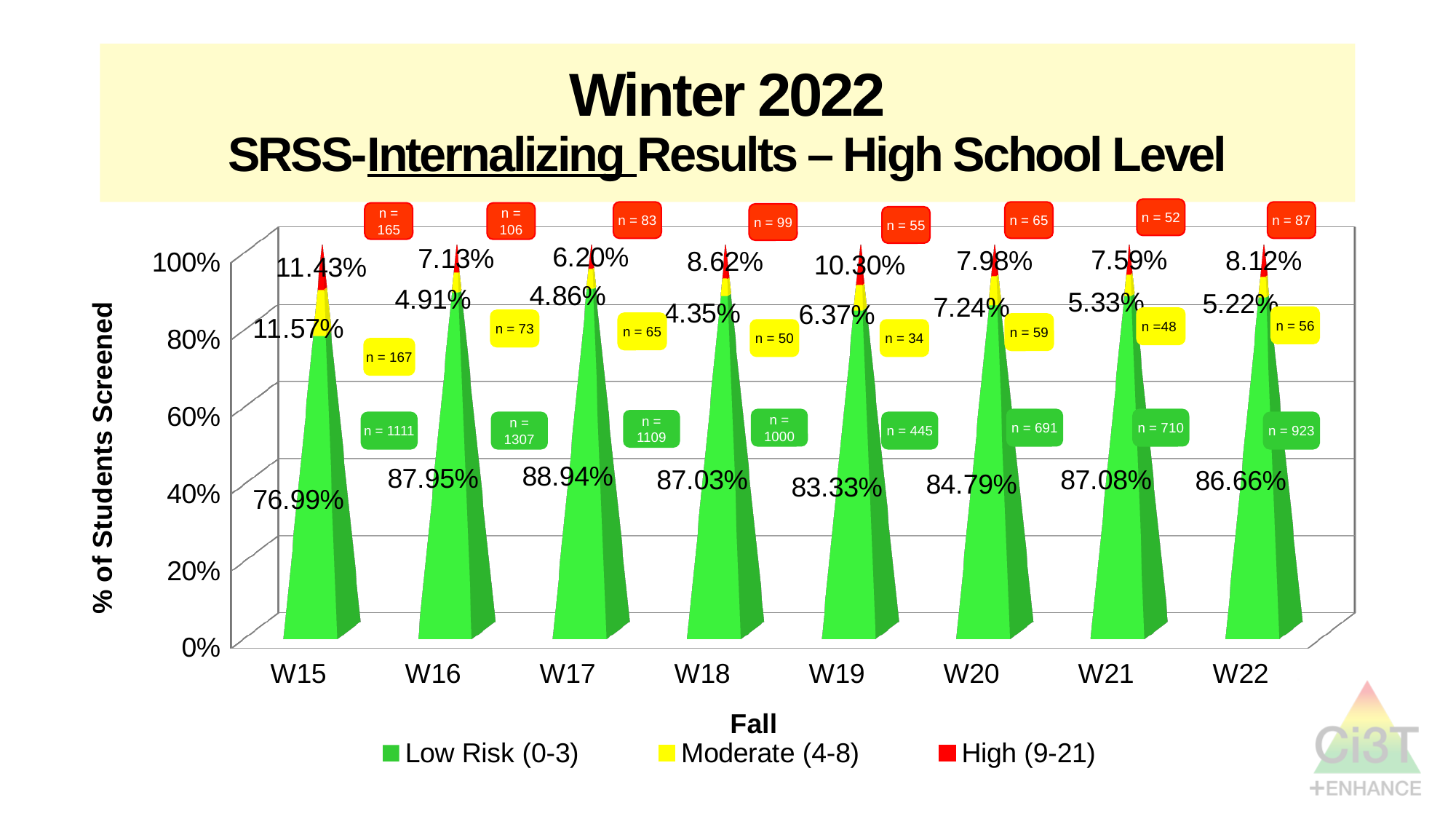
What is the label of the y axis? % of Students Screened What is the Low Risk (0-3) percentage for W15? 76.99% How many schools are shown on the x axis? 8 Which school has the lowest Low Risk (0-3) percentage? W15 Which school has the highest Low Risk (0-3) percentage? W17 Which school has the highest High (9-21) percentage? W15 What is the Moderate (4-8) percentage for W20? 7.24% What is the High (9-21) percentage for W19? 10.30% How many series does the legend list? 3 Which is larger, the Moderate (4-8) percentage for W19 or for W21? W19 What kind of chart is shown on the slide? Stacked bar chart What is the difference between the Low Risk (0-3) percentages for W17 and W15? 11.95%